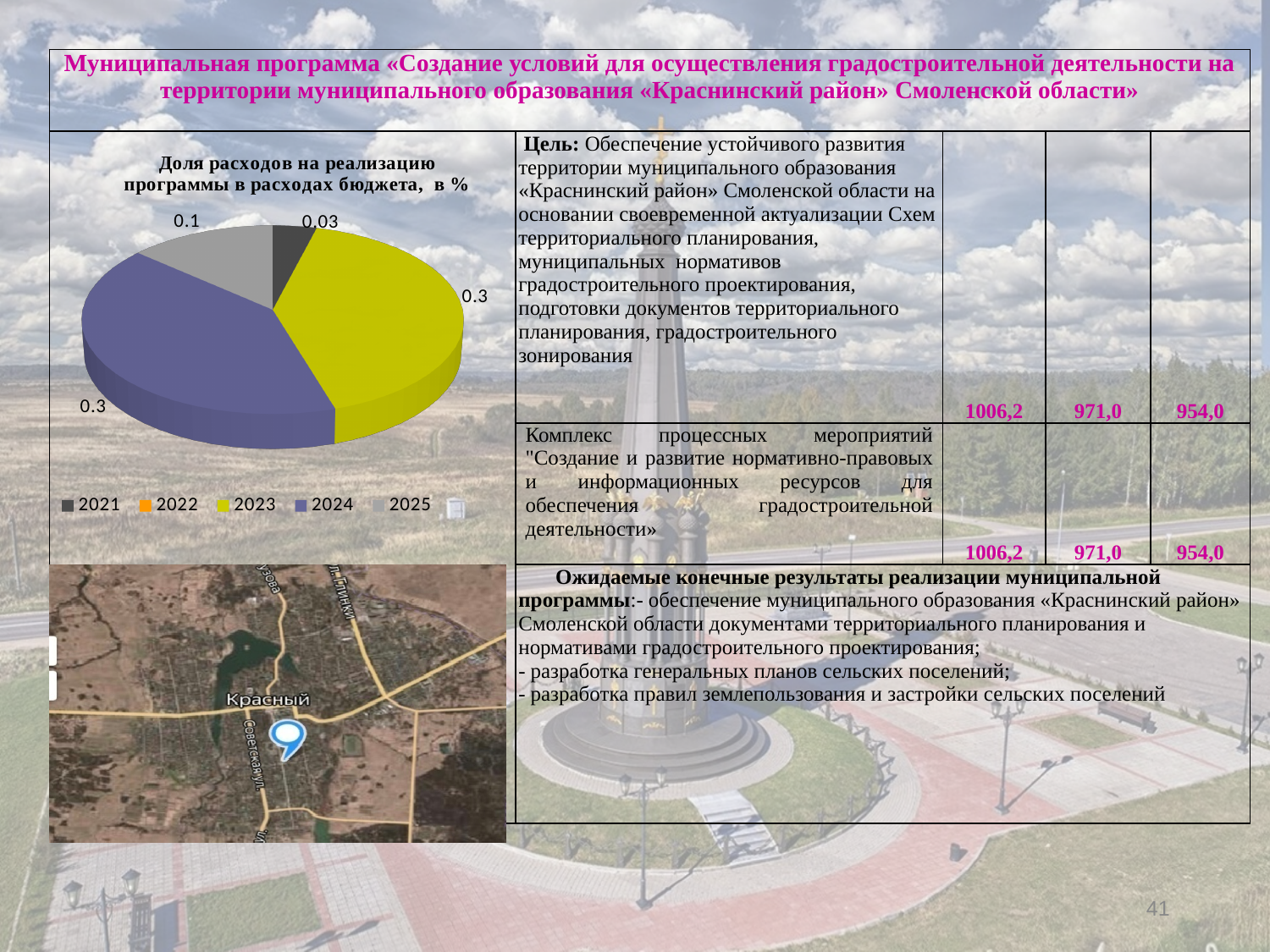
What value is shown for 2021 in the pie chart? 0.03 What value is shown for 2023 in the pie chart? 0.3 What value is shown for 2025 in the pie chart? 0.1 What value is shown for 2024 in the pie chart? 0.3 Which is larger in the pie chart, the value for 2024 or the value for 2025? 2024 What is the difference between the values for 2024 and 2025 in the pie chart? 0.2 Among the labelled slices of the pie chart, which year has the smallest value? 2021 What kind of chart is shown on the slide? Pie chart What is the title of the pie chart? Доля расходов на реализацию программы в расходах бюджета, в % What colour represents 2024 in the pie chart? Purple How many entries does the legend of the pie chart list? 5 What is the difference between the values for 2023 and 2021 in the pie chart? 0.27